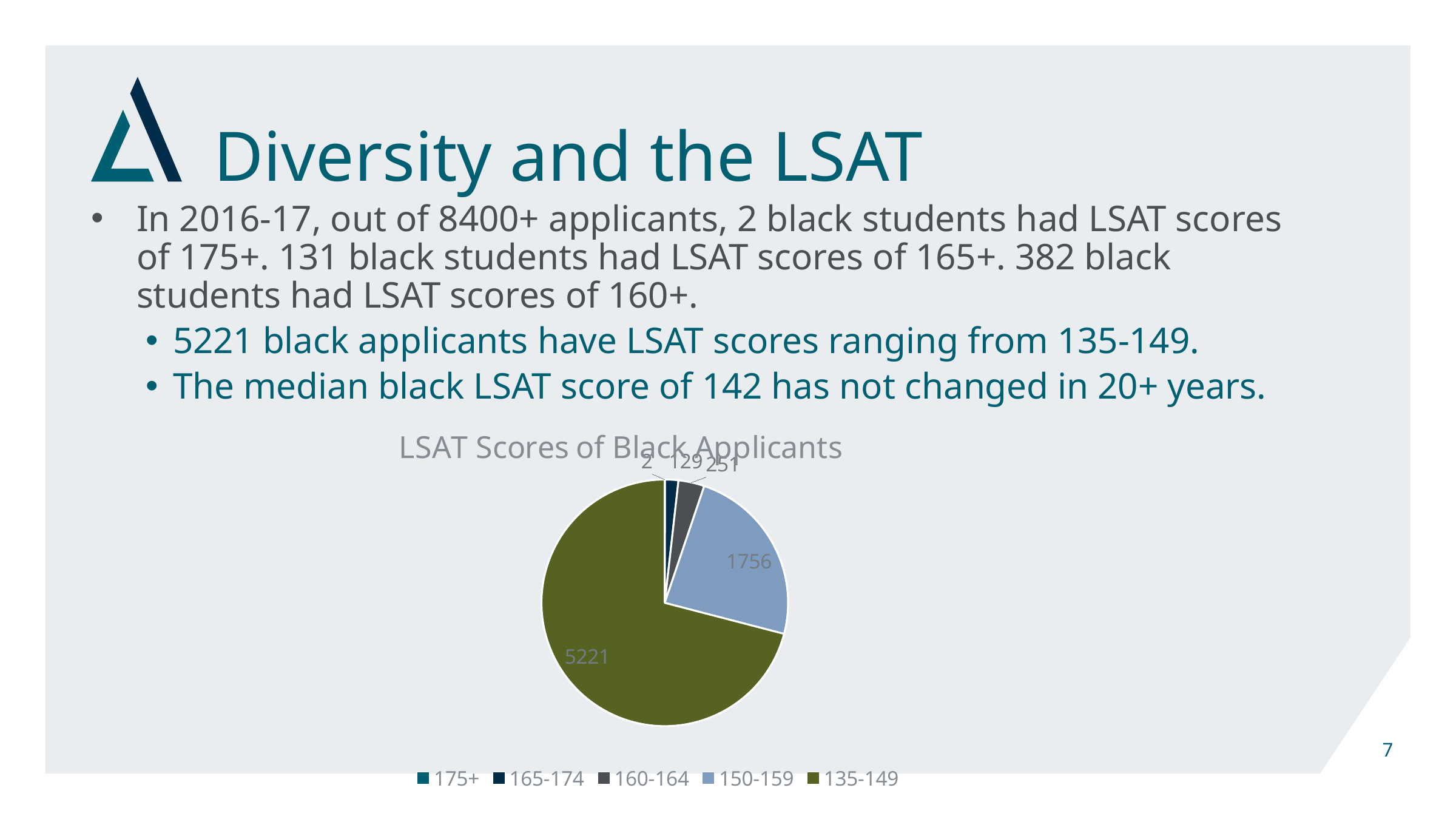
How many black applicants had LSAT scores in the 135-149 range according to the chart? 5221 Which score range has the largest slice in the pie chart? 135-149 What value is shown for the 150-159 slice of the pie chart? 1756 How many score ranges are shown in the pie chart? 5 What kind of chart is shown on the slide? pie chart How many more applicants are in the 135-149 range than in the 150-159 range? 3465 Which score range has the smallest slice in the pie chart? 175+ How many entries does the chart legend list? 5 Which slice is larger, 150-159 or 160-164? 150-159 What value is shown for the 160-164 slice of the pie chart? 251 What is the title of the chart? LSAT Scores of Black Applicants What value is shown for the 175+ slice of the pie chart? 2